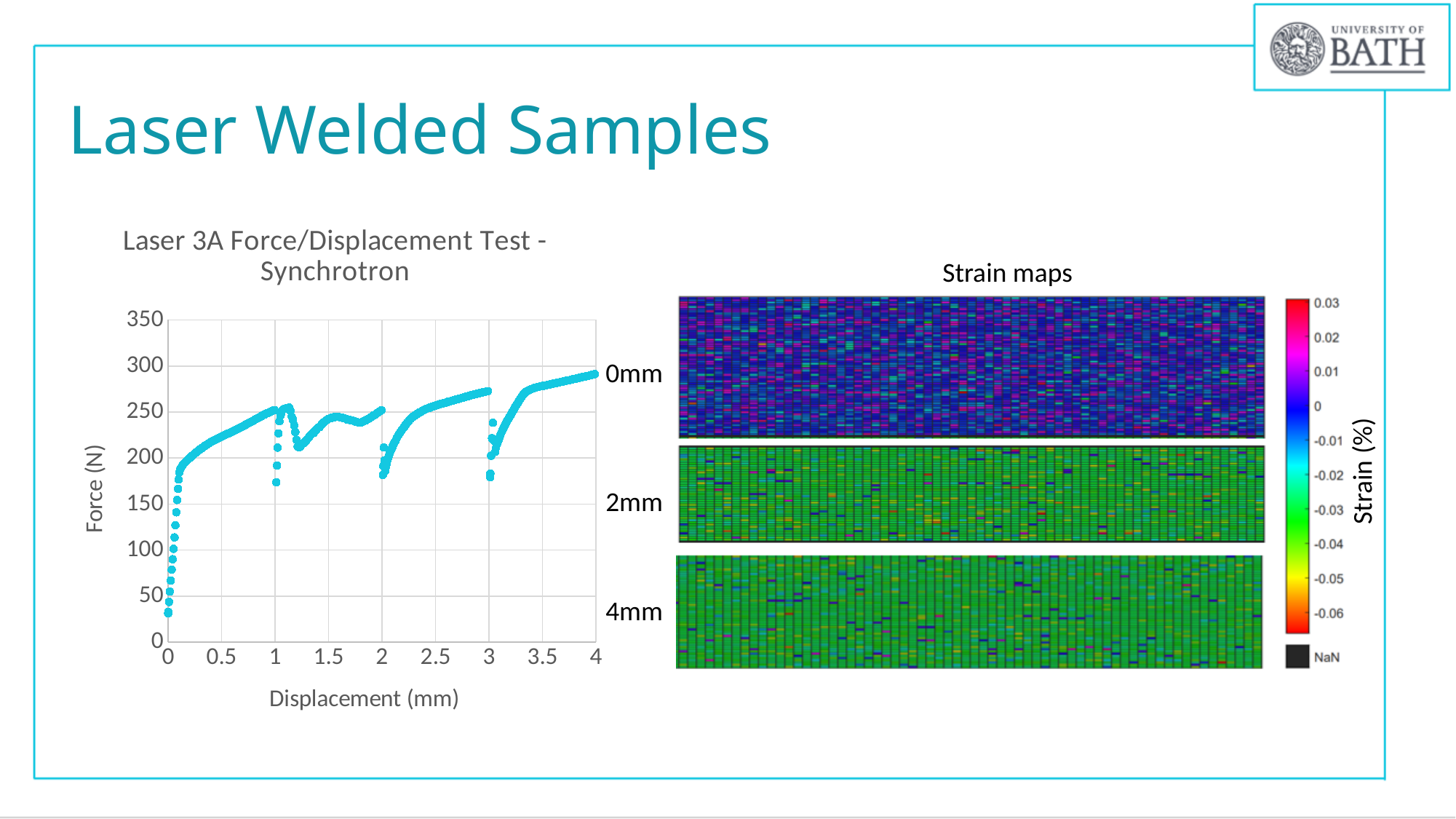
In the Laser 3A Force/Displacement Test chart, is the force at a displacement of 4 mm greater or less than 250? greater What kind of chart is the Laser 3A Force/Displacement Test - Synchrotron chart? Scatter chart What is the title of the chart on the left of the slide? Laser 3A Force/Displacement Test - Synchrotron How many strain maps are shown on the slide? 3 In the Laser 3A Force/Displacement Test chart, is the force at a displacement of 0 mm greater or less than 50? less In the Laser 3A Force/Displacement Test chart, what is the highest value shown on the Force (N) axis? 350 In the Laser 3A Force/Displacement Test chart, is the force at a displacement of 3.5 mm greater or less than 250? greater In the Laser 3A Force/Displacement Test chart, does the force overall rise or fall as displacement increases from 0 to 4 mm? rise In the Laser 3A Force/Displacement Test chart, what is the largest displacement value shown on the horizontal axis? 4